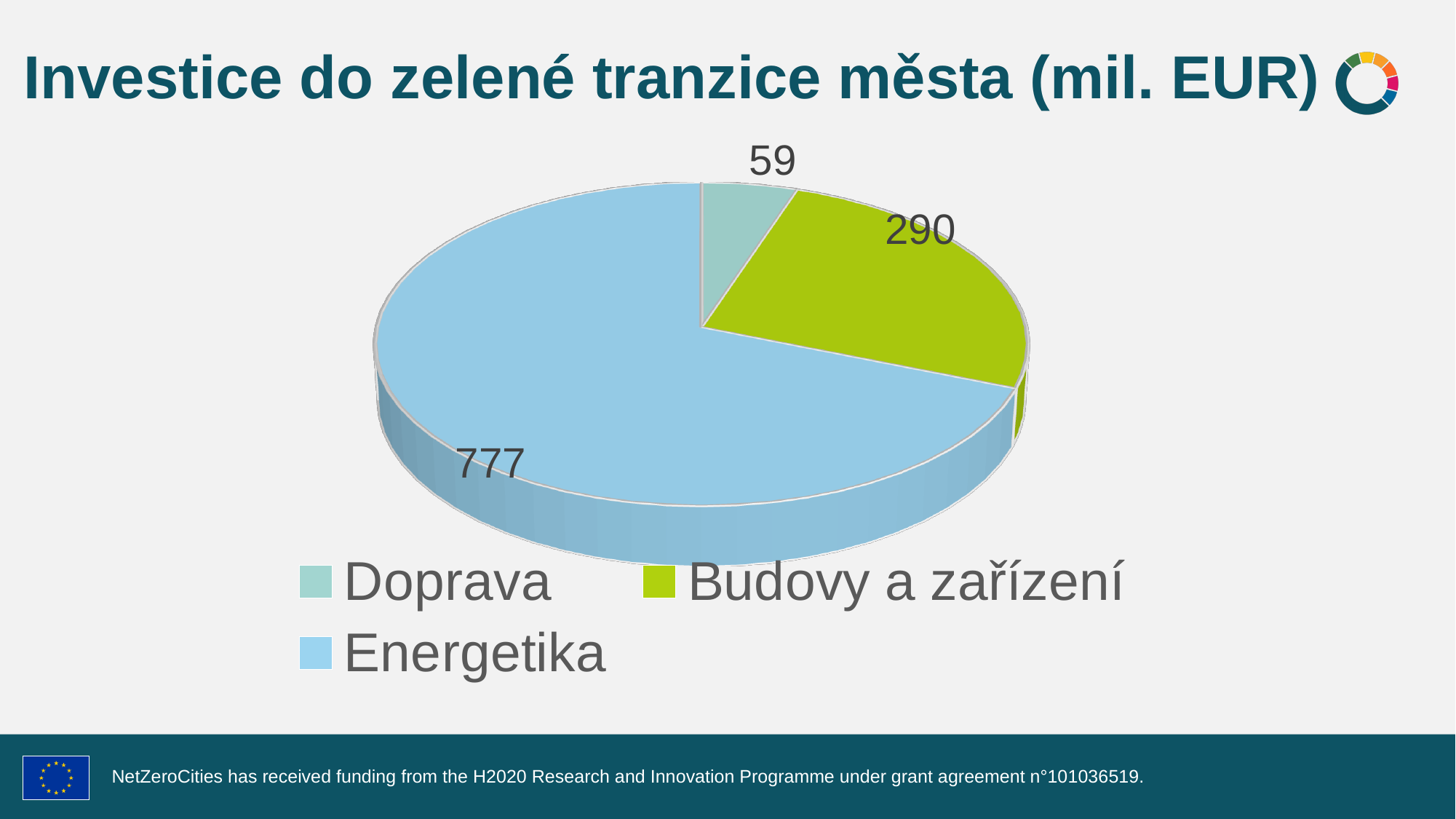
What is the value for Budovy a zařízení? 290 Which category has the largest slice? Energetika Which category has the smallest slice? Doprava What is the value for Doprava? 59 What is the value for Energetika? 777 How many categories does the pie chart have? 3 What is the difference between the values for Energetika and Budovy a zařízení? 487 Which is larger, the value for Doprava or the value for Budovy a zařízení? Budovy a zařízení What is the title of the chart? Investice do zelené tranzice města (mil. EUR) What is the difference between the values for Budovy a zařízení and Doprava? 231 What type of chart is shown on the slide? pie chart What is the total of all slices in the pie chart? 1126